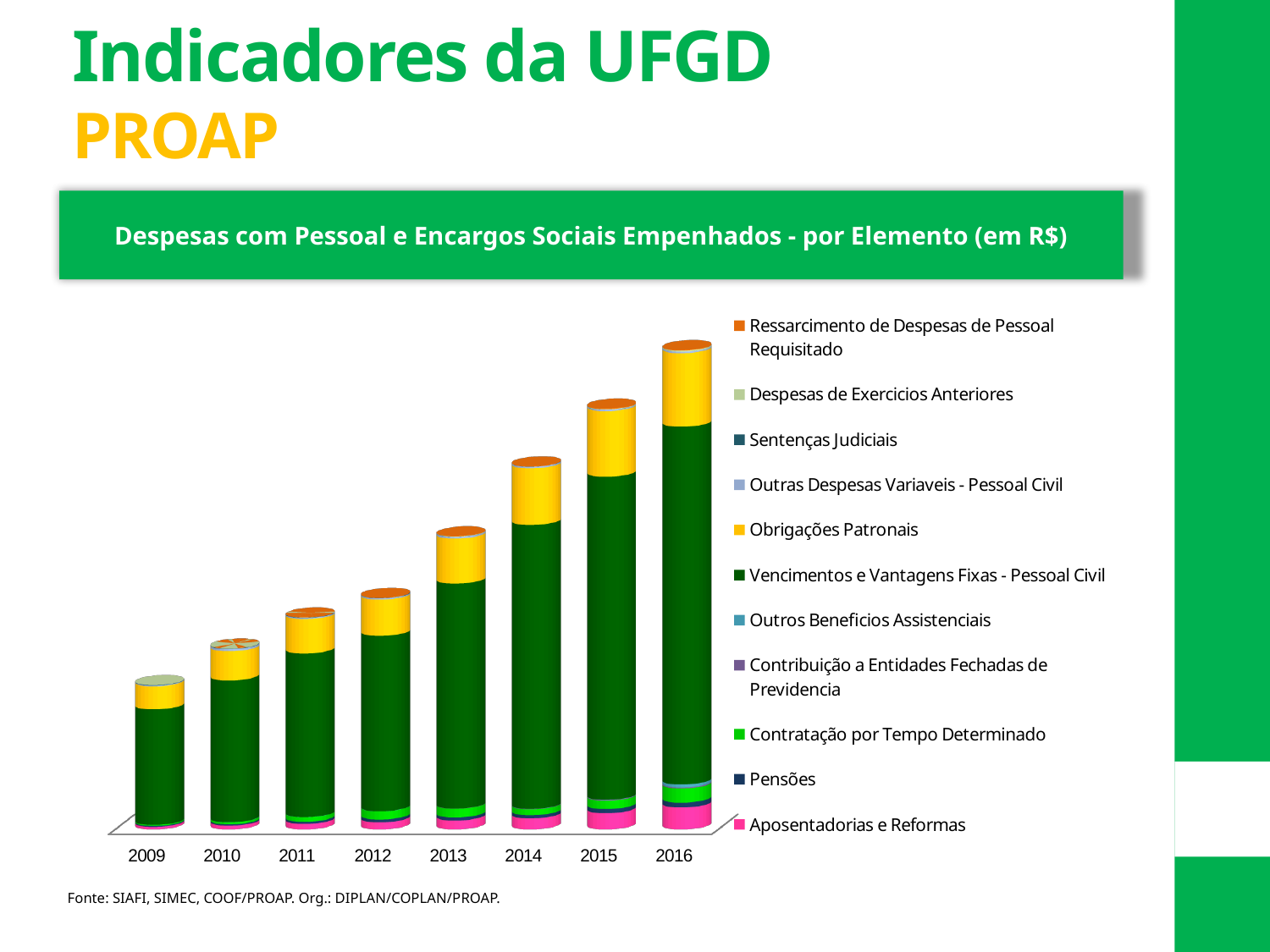
Which series makes up the largest portion of each stacked bar? Vencimentos e Vantagens Fixas - Pessoal Civil What is the title of the chart? Despesas com Pessoal e Encargos Sociais Empenhados - por Elemento (em R$) Do the total expenses rise or fall from 2009 to 2016? Rise How many years are shown along the x axis of the chart? 8 How many series does the chart's legend list? 11 Which year has the larger total bar, 2010 or 2013? 2013 What colour represents Obrigações Patronais in the legend? Yellow What is the first year shown on the x axis? 2009 Which year has the larger total bar, 2012 or 2015? 2015 Which year has the tallest stacked bar? 2016 Which year has the shortest stacked bar? 2009 What kind of chart is shown on the slide? Stacked bar chart